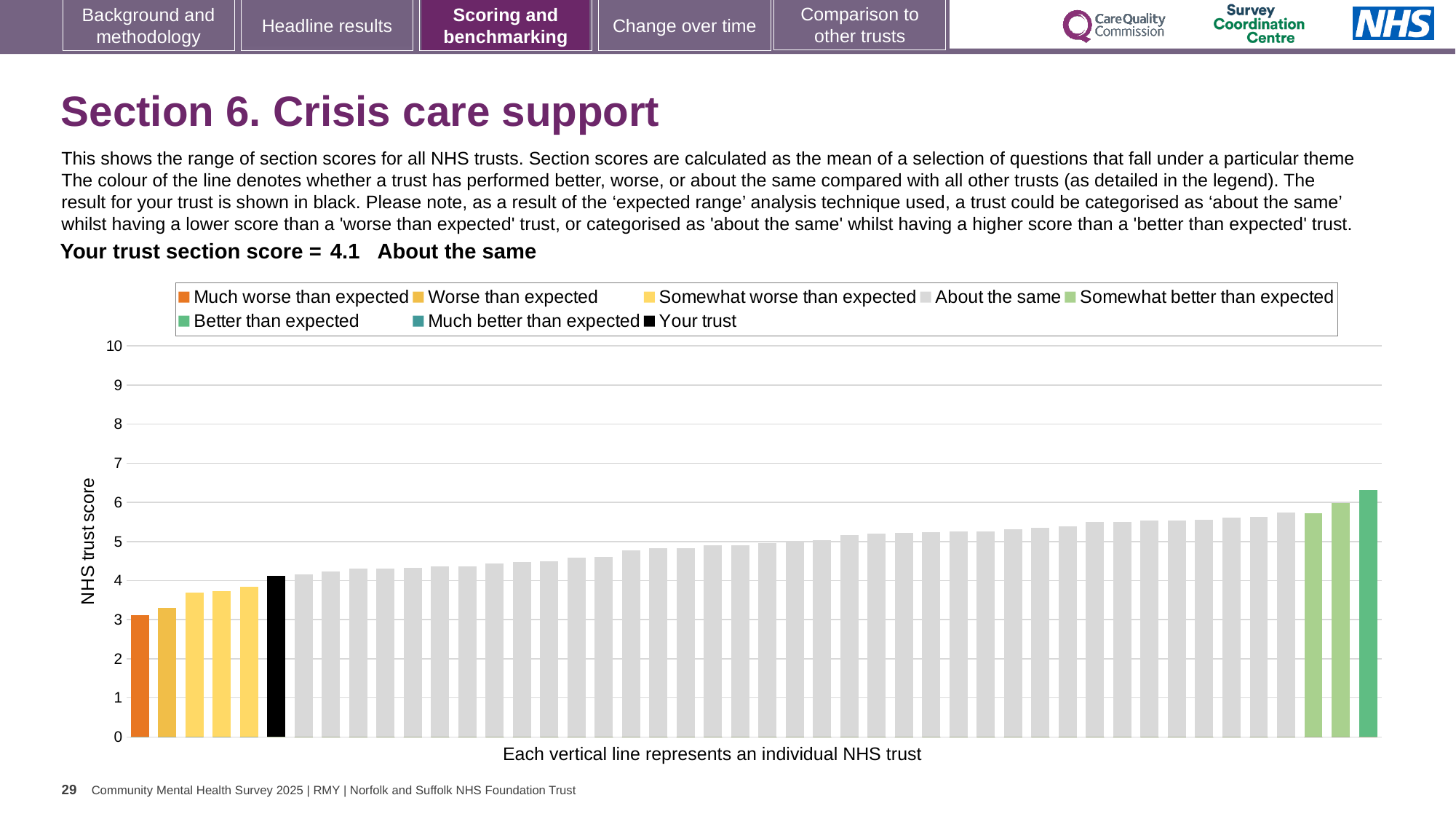
Is the value of the shortest bar greater or less than 4? less Is the value of the black 'Your trust' bar greater or less than 5? less What is the section score for your trust shown on the slide? 4.1 Is the value of the tallest bar greater or less than 7? less Which legend category does the tallest bar belong to? Better than expected What kind of chart is shown on the slide? bar chart How many entries does the chart legend list? 8 What is the highest value shown on the vertical axis? 10 Which category is your trust placed in for this section? About the same What is the label on the vertical axis of the chart? NHS trust score Which legend category does the shortest bar belong to? Much worse than expected